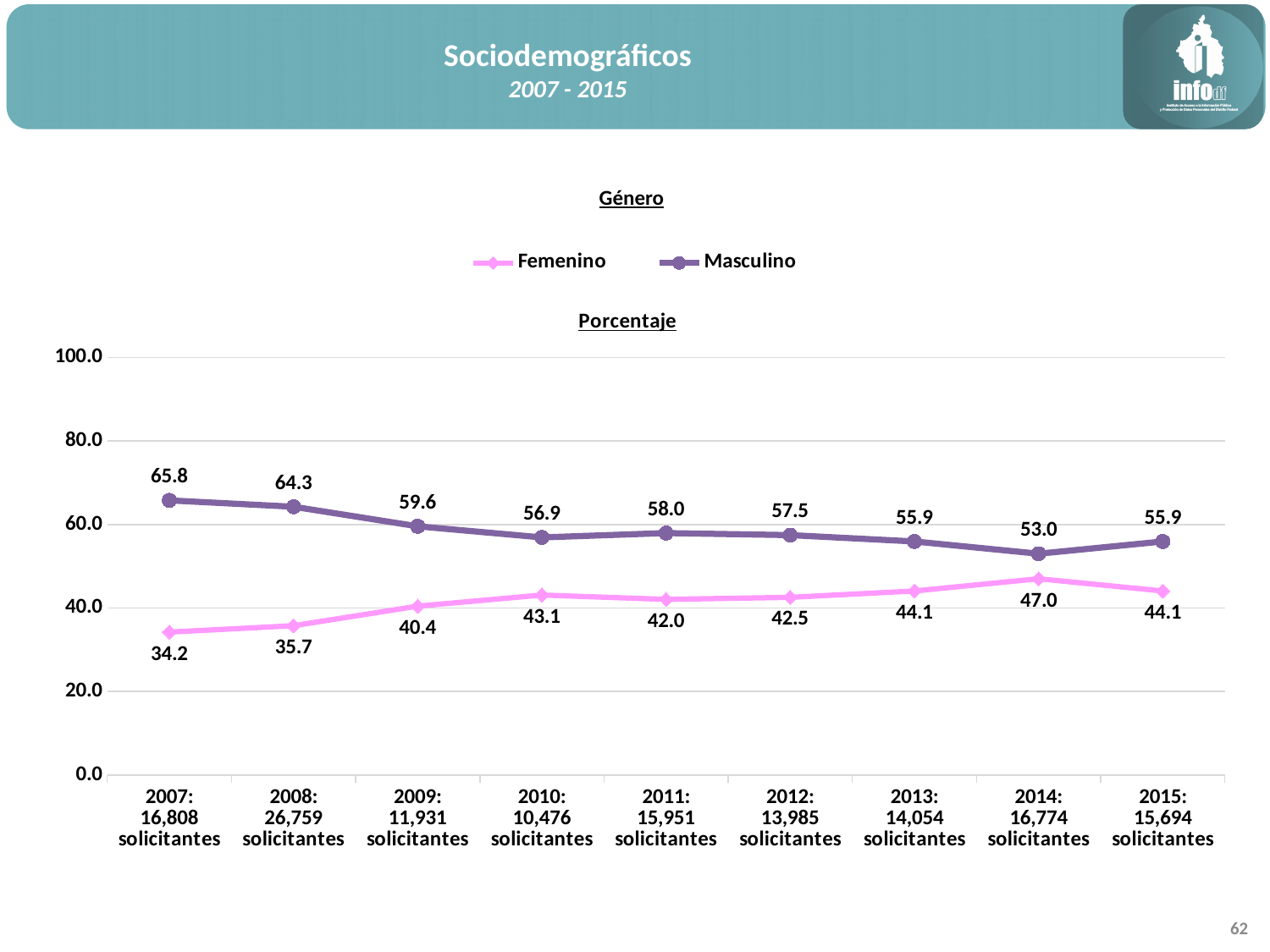
What is the Femenino percentage for 2011? 42.0 What is the difference between the Masculino and Femenino percentages in 2015? 11.8 What is the difference between the Masculino and Femenino percentages in 2007? 31.6 In which year is the Femenino percentage highest? 2014 What is the Femenino percentage for 2014? 47.0 How many series does the legend list? 2 Which series has the larger value in 2010, Femenino or Masculino? Masculino In which year is the Masculino percentage lowest? 2014 How many years are shown on the x axis? 9 Does the Masculino line generally rise or fall from 2007 to 2014? Fall What is the Masculino percentage for 2007? 65.8 What kind of chart is shown? Line chart